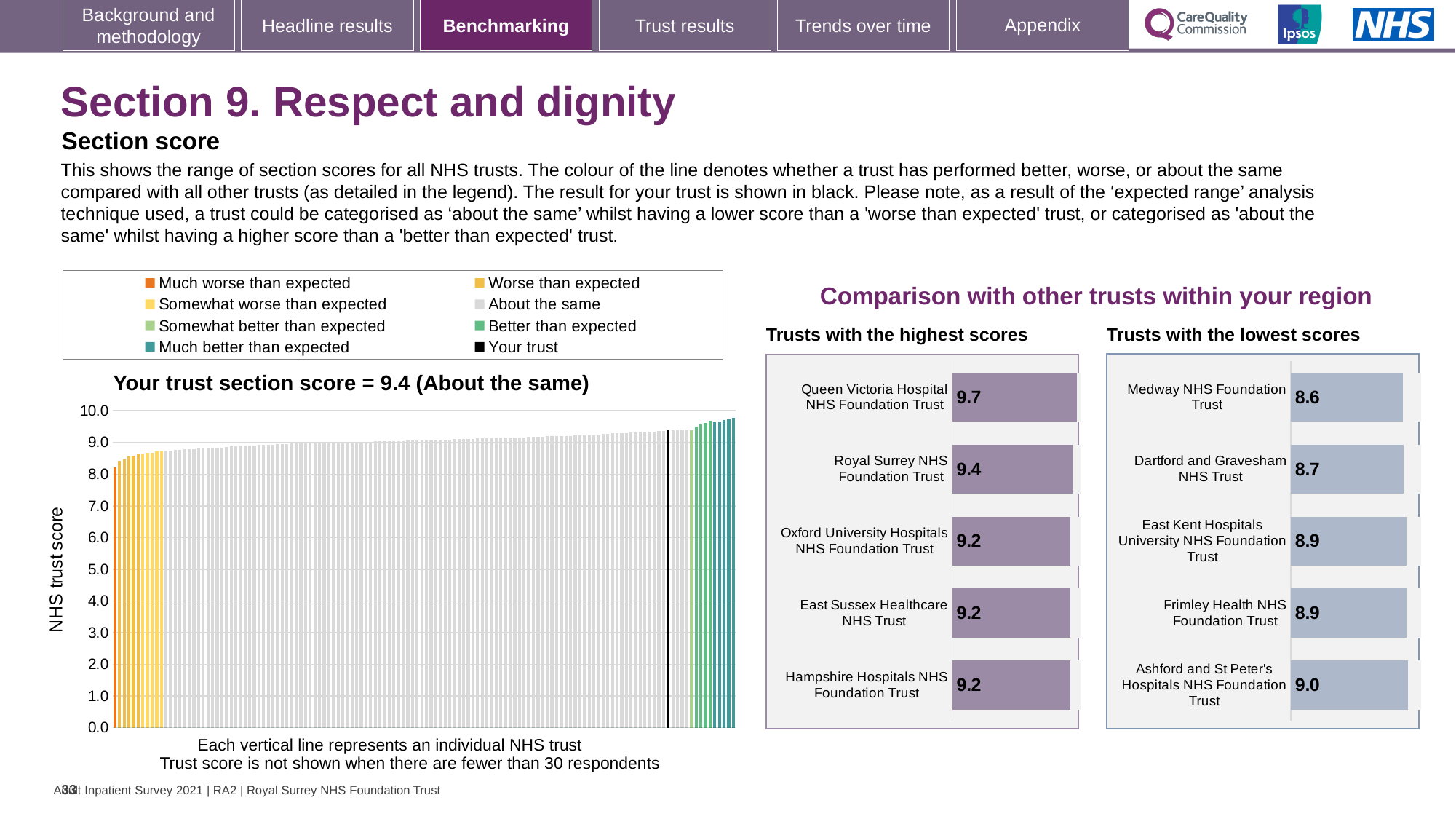
In the 'Trusts with the highest scores' chart, which trust has the highest score? Queen Victoria Hospital NHS Foundation Trust In the 'Trusts with the lowest scores' chart, which trust has the lowest score? Medway NHS Foundation Trust In the 'Trusts with the highest scores' chart, what is the score for Queen Victoria Hospital NHS Foundation Trust? 9.7 In the 'Trusts with the lowest scores' chart, what is the score for Medway NHS Foundation Trust? 8.6 In the 'Trusts with the lowest scores' chart, what is the score for Ashford and St Peter's Hospitals NHS Foundation Trust? 9.0 How many entries does the legend above the 'Your trust section score' chart list? 8 In the 'Trusts with the highest scores' chart, what is the difference between the scores of Queen Victoria Hospital NHS Foundation Trust and Royal Surrey NHS Foundation Trust? 0.3 In the 'Your trust section score' chart on the left, what is the section score for your trust? 9.4 How many trusts are shown in the 'Trusts with the lowest scores' chart? 5 In the 'Trusts with the lowest scores' chart, what is the difference between the scores of Ashford and St Peter's Hospitals NHS Foundation Trust and Medway NHS Foundation Trust? 0.4 Which is larger: the score for Dartford and Gravesham NHS Trust in the lowest scores chart or the score for Oxford University Hospitals NHS Foundation Trust in the highest scores chart? Oxford University Hospitals NHS Foundation Trust In the 'Trusts with the highest scores' chart, what is the score for Royal Surrey NHS Foundation Trust? 9.4